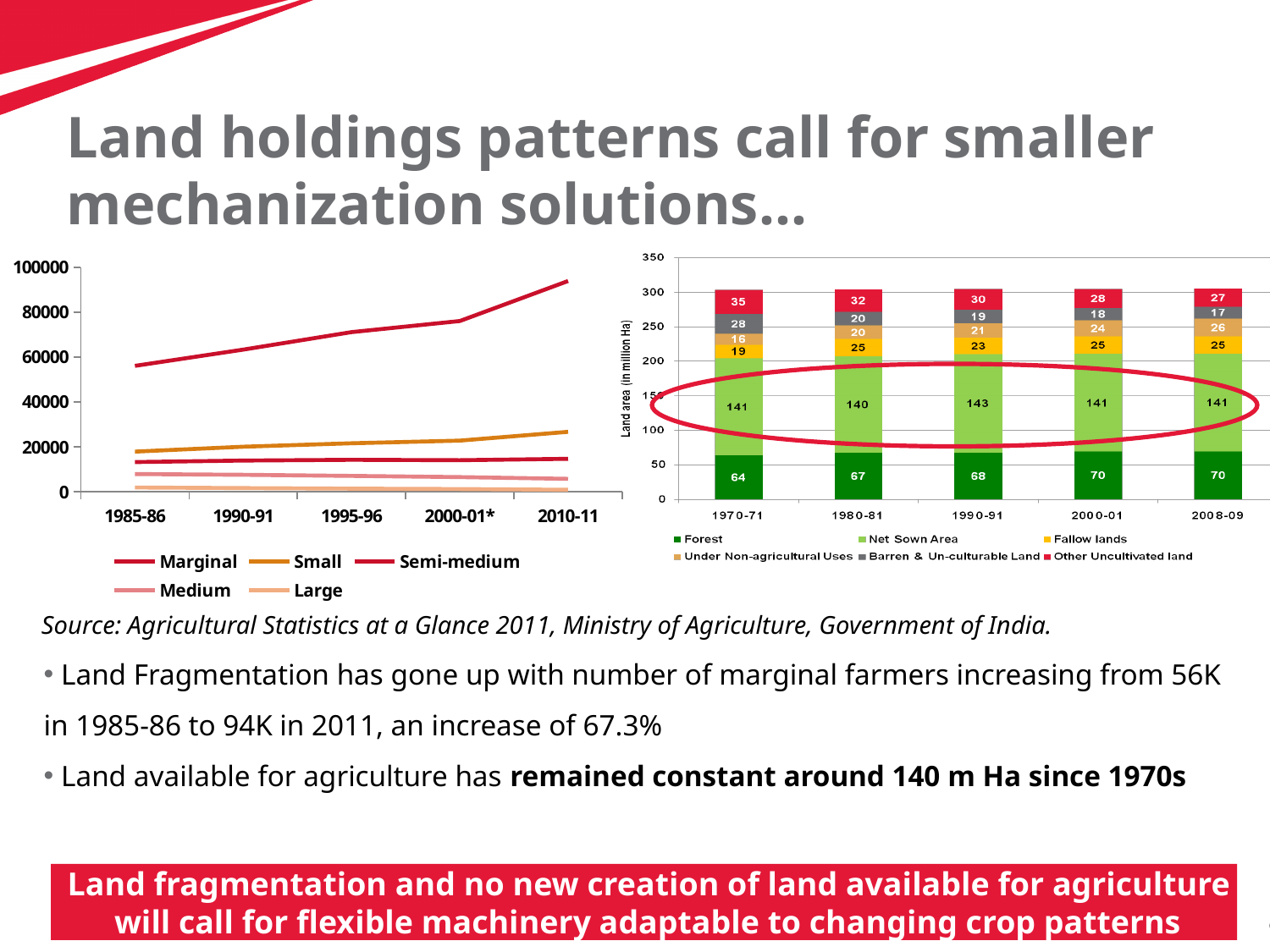
How many series does the legend of the chart on the left list? 5 In the chart on the right, what is the difference between the Forest value in 2008-09 and in 1970-71? 6 In the chart on the right, what is the Forest value for 1970-71? 64 What kind of chart is the chart on the right of the slide? bar chart In the chart on the left, is the value for Marginal in 2010-11 greater or less than 80000? greater In the chart on the right, which year has the highest Net Sown Area value? 1990-91 How many series does the legend of the chart on the right list? 6 In the chart on the right, what is the Net Sown Area value for 1990-91? 143 In the chart on the right, which year has the lowest Forest value? 1970-71 In the chart on the right, what is the total of the stacked bar for 1970-71? 303 In the chart on the right, is the Other Uncultivated land value larger in 1970-71 or in 2008-09? 1970-71 In the chart on the left, does the Marginal line rise or fall from 1985-86 to 2010-11? rise